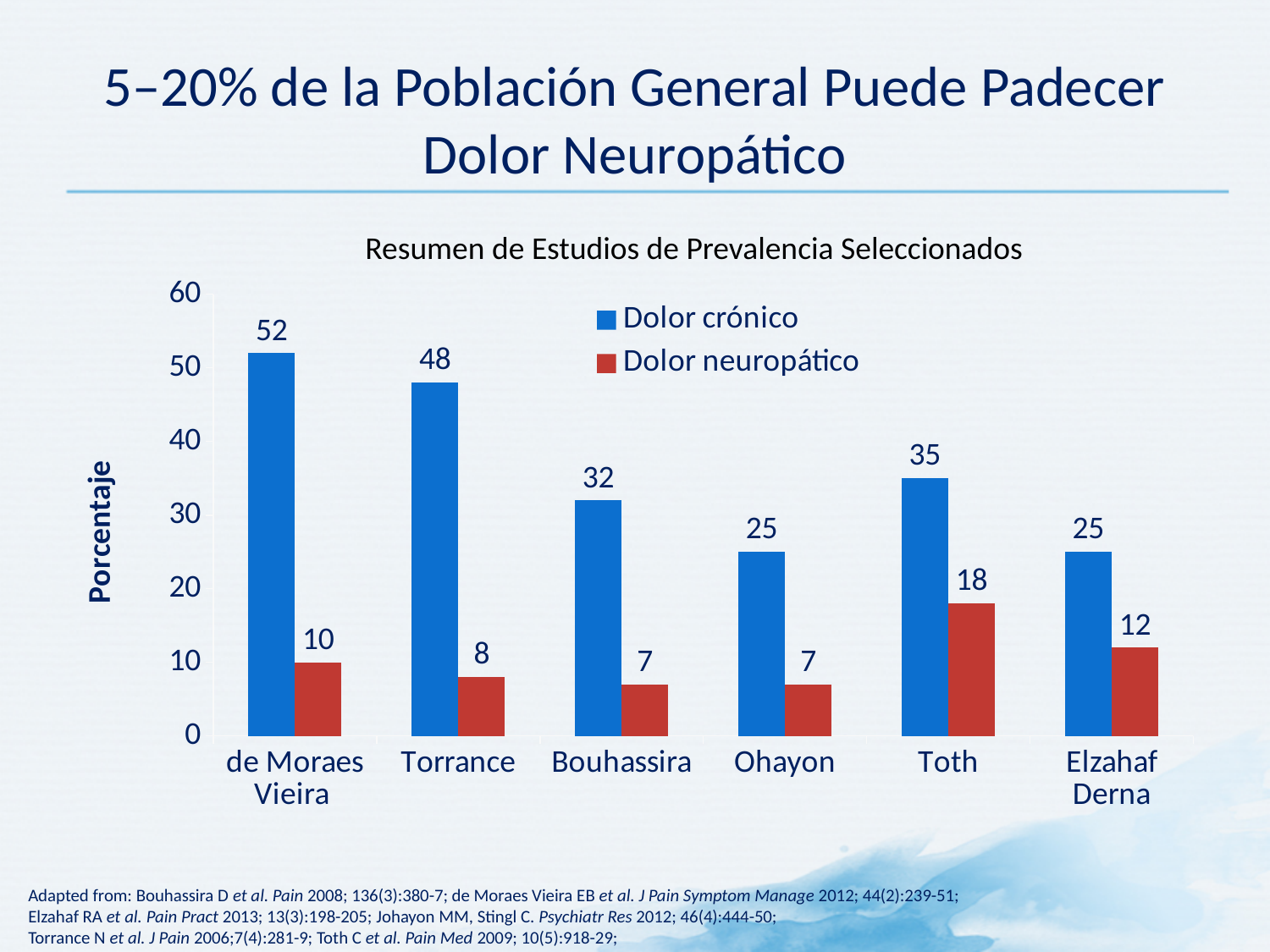
What is the title of the chart? Resumen de Estudios de Prevalencia Seleccionados What is the Dolor neuropático value for Toth? 18 How many series does the legend list? 2 What is the Dolor neuropático value for Bouhassira? 7 Which study has the highest Dolor neuropático value? Toth What is the Dolor crónico value for Torrance? 48 What is the label of the y axis? Porcentaje How many studies are shown on the x axis? 6 What is the difference between the Dolor crónico and Dolor neuropático values for de Moraes Vieira? 42 What kind of chart is shown? Bar chart Which is larger, the Dolor neuropático value for Elzahaf Derna or for Torrance? Elzahaf Derna Which study has the highest Dolor crónico value? de Moraes Vieira